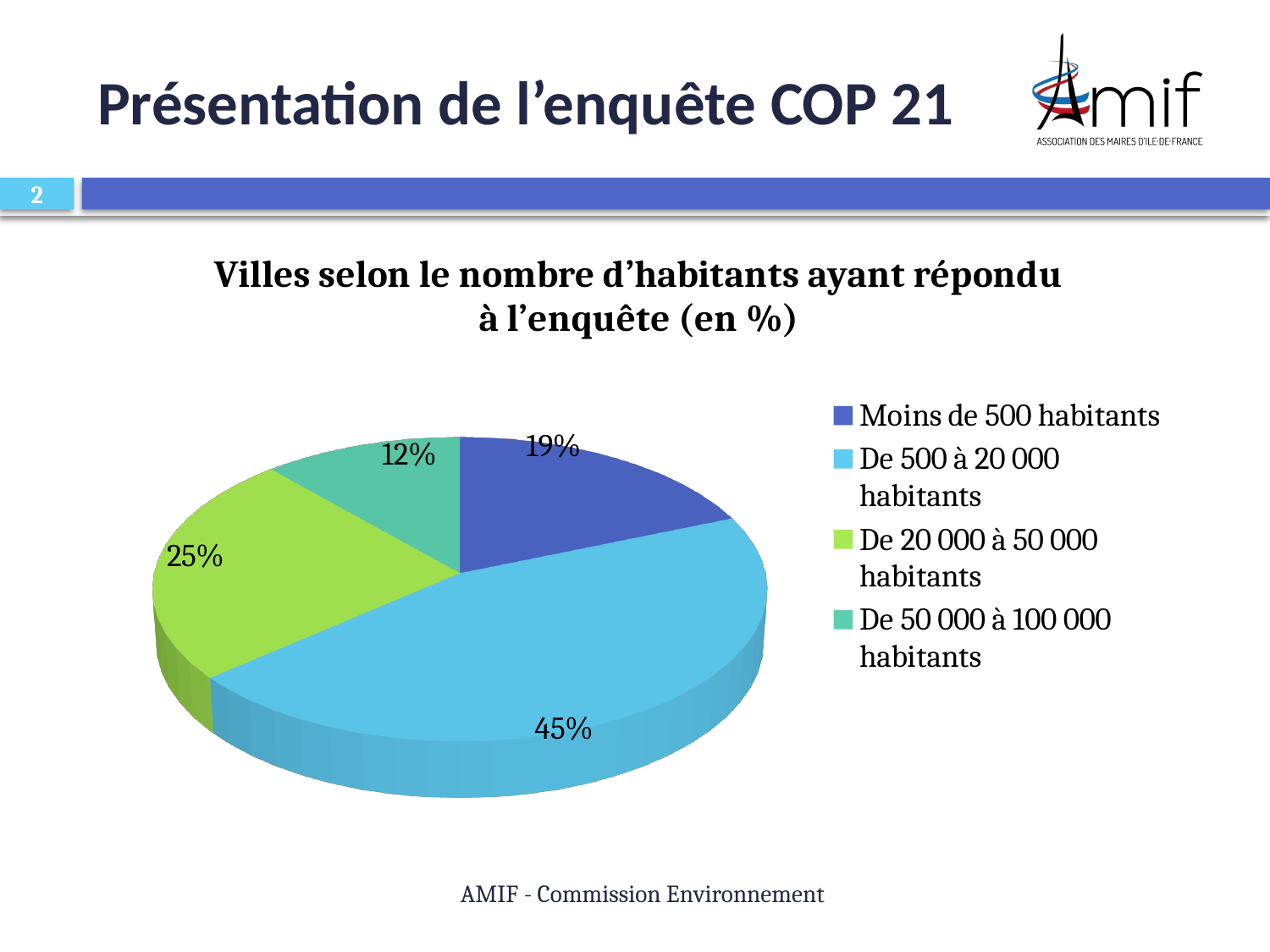
What is the difference between the 'De 500 à 20 000 habitants' slice and the 'De 20 000 à 50 000 habitants' slice? 20% How many categories does the pie chart show? 4 Which is larger: the 'Moins de 500 habitants' slice or the 'De 50 000 à 100 000 habitants' slice? Moins de 500 habitants What is the title of the chart? Villes selon le nombre d'habitants ayant répondu à l'enquête (en %) What is the value shown for 'De 20 000 à 50 000 habitants'? 25% What colour is the slice for 'De 20 000 à 50 000 habitants'? Green Which category has the largest slice of the pie? De 500 à 20 000 habitants What share of the pie does the 'De 500 à 20 000 habitants' slice represent? 45% What kind of chart is shown on the slide? Pie chart What is the value shown for 'Moins de 500 habitants'? 19% Which category has the smallest slice of the pie? De 50 000 à 100 000 habitants What is the value shown for 'De 50 000 à 100 000 habitants'? 12%